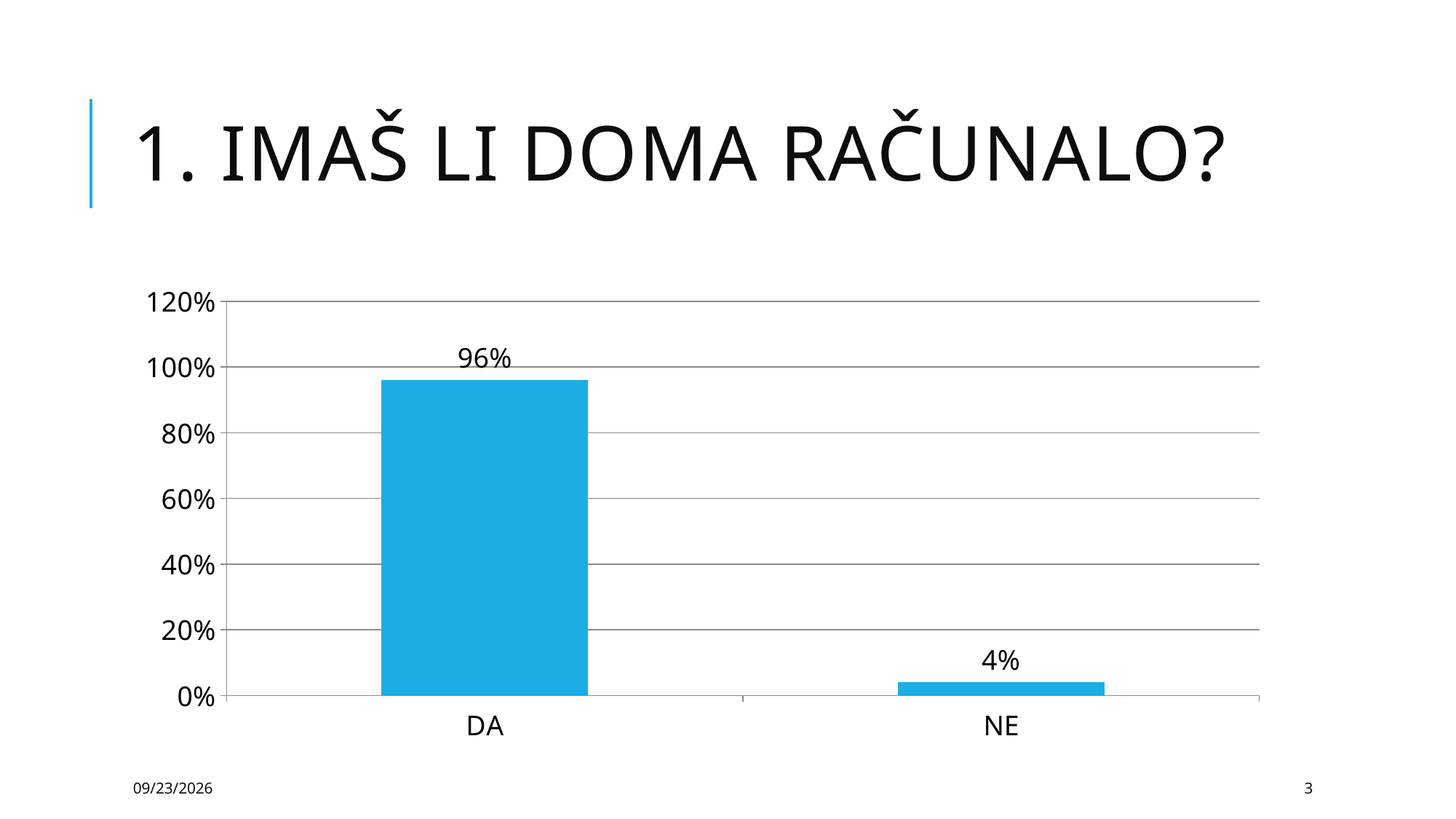
Is the value for DA greater or less than 80%? greater How many categories are shown on the x axis? 2 What colour are the bars in the chart? blue What is the value for NE? 4% What is the highest value shown on the y axis? 120% Which category has the lowest value? NE Which is larger, the value for DA or the value for NE? DA What is the difference between the values for DA and NE? 92% What kind of chart is shown on the slide? bar chart Is the value for NE greater or less than 20%? less Which category has the highest value? DA What is the value for DA? 96%